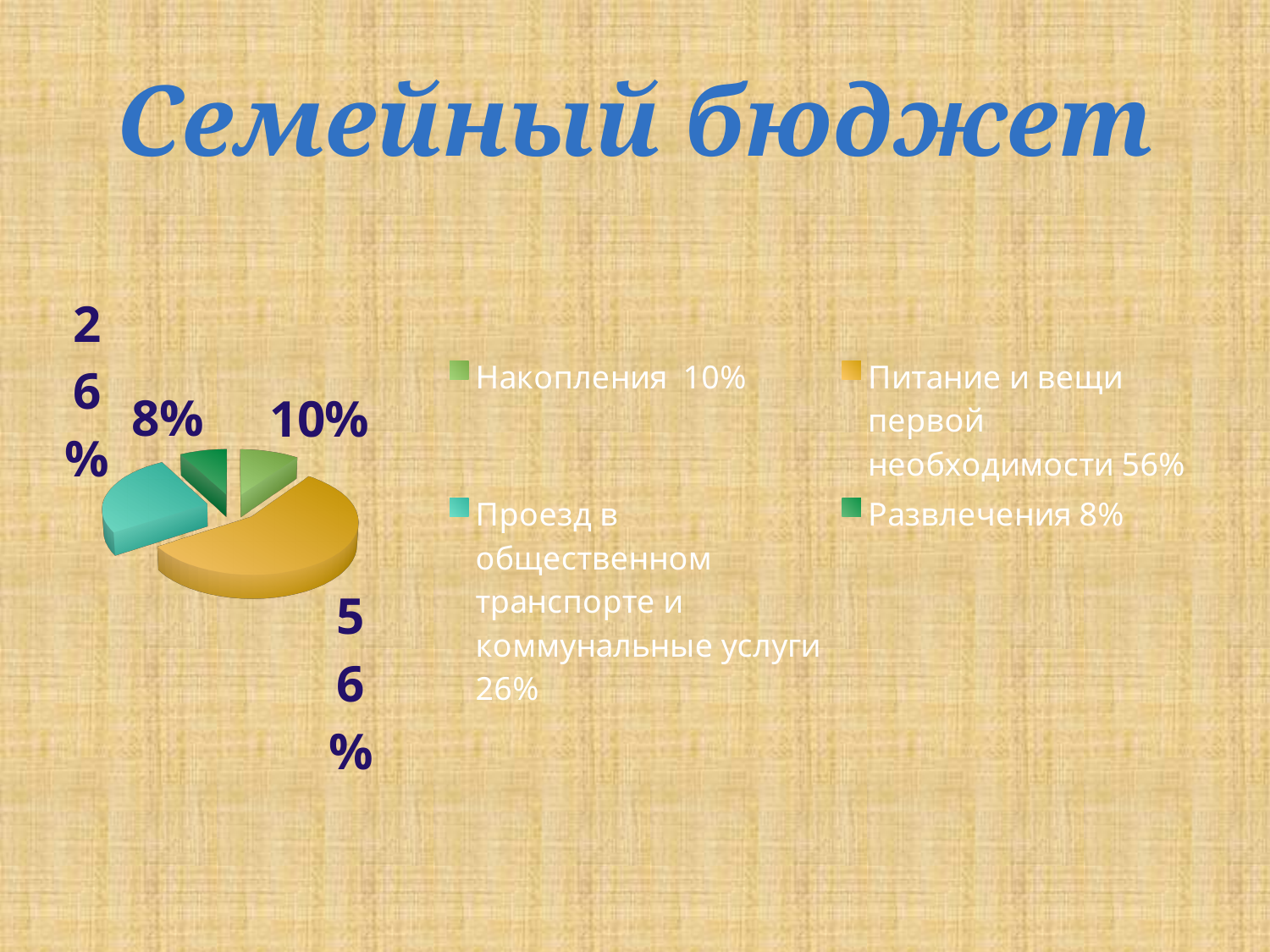
Which category has the largest share of the family budget? Питание и вещи первой необходимости How many categories does the pie chart show? 4 What colour is the slice for Питание и вещи первой необходимости? orange What kind of chart is shown on the slide? pie chart What share of the family budget goes to Проезд в общественном транспорте и коммунальные услуги? 26% Which category has the smallest share of the family budget? Развлечения What is the difference between the share for Питание и вещи первой необходимости and the share for Проезд в общественном транспорте и коммунальные услуги? 30% What share of the family budget goes to Накопления? 10% Which is larger: the share for Накопления or the share for Развлечения? Накопления What share of the family budget goes to Развлечения? 8% What share of the family budget goes to Питание и вещи первой необходимости? 56% What is the title of the slide? Семейный бюджет